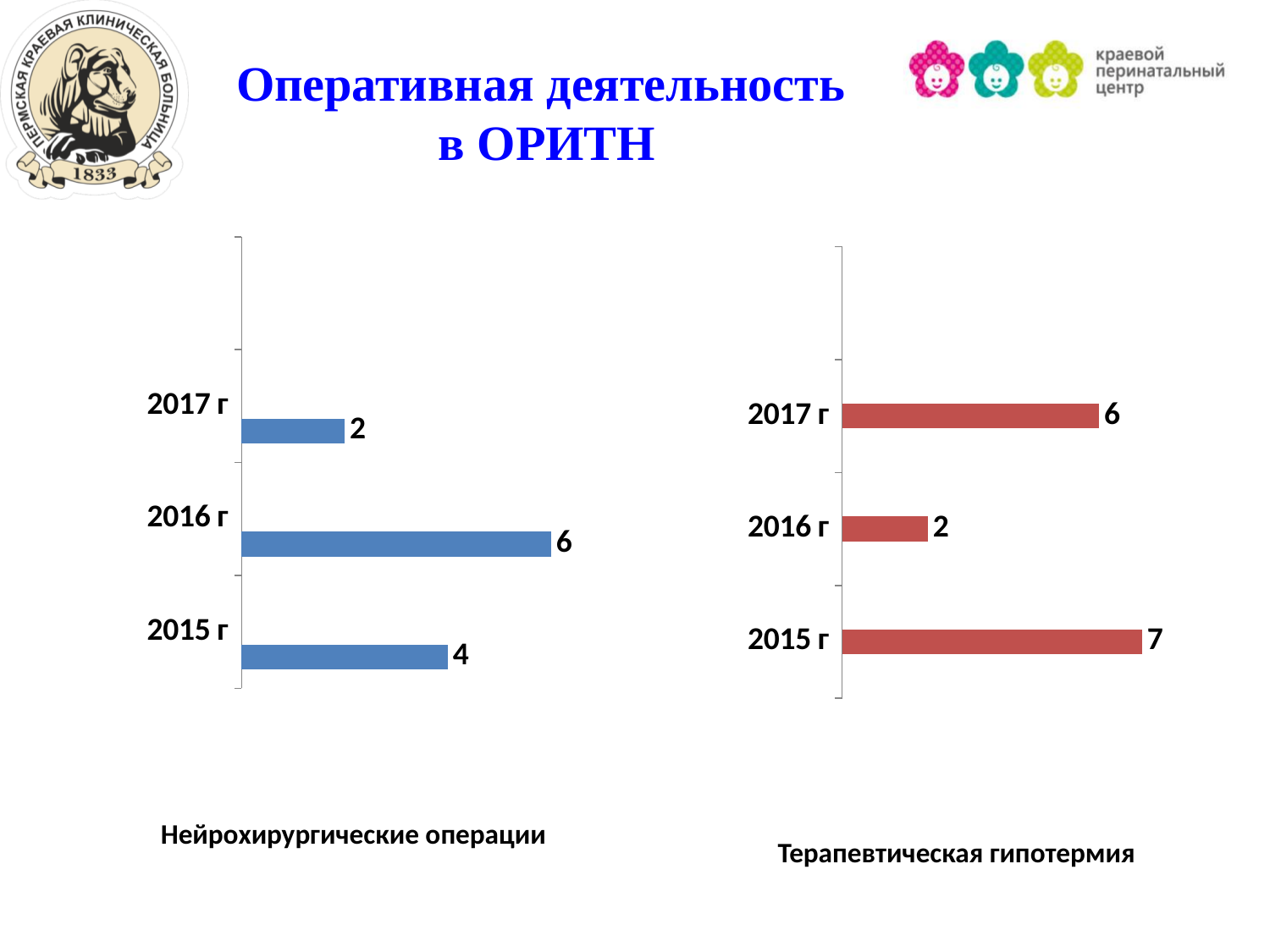
In the left chart (Нейрохирургические операции), which year has the highest value? 2016 г How many years are shown in the right chart (Терапевтическая гипотермия)? 3 In the left chart (Нейрохирургические операции), what is the value for 2017 г? 2 In the left chart (Нейрохирургические операции), which is larger: the value for 2015 г or 2017 г? 2015 г In the right chart (Терапевтическая гипотермия), what is the value for 2015 г? 7 What colour are the bars in the right chart (Терапевтическая гипотермия)? Red In the right chart (Терапевтическая гипотермия), what is the value for 2016 г? 2 In the left chart (Нейрохирургические операции), what is the difference between the values for 2016 г and 2015 г? 2 What kind of chart is the left chart (Нейрохирургические операции)? Bar chart In the left chart (Нейрохирургические операции), what is the value for 2016 г? 6 In the right chart (Терапевтическая гипотермия), what is the difference between the values for 2015 г and 2017 г? 1 In the right chart (Терапевтическая гипотермия), which year has the lowest value? 2016 г